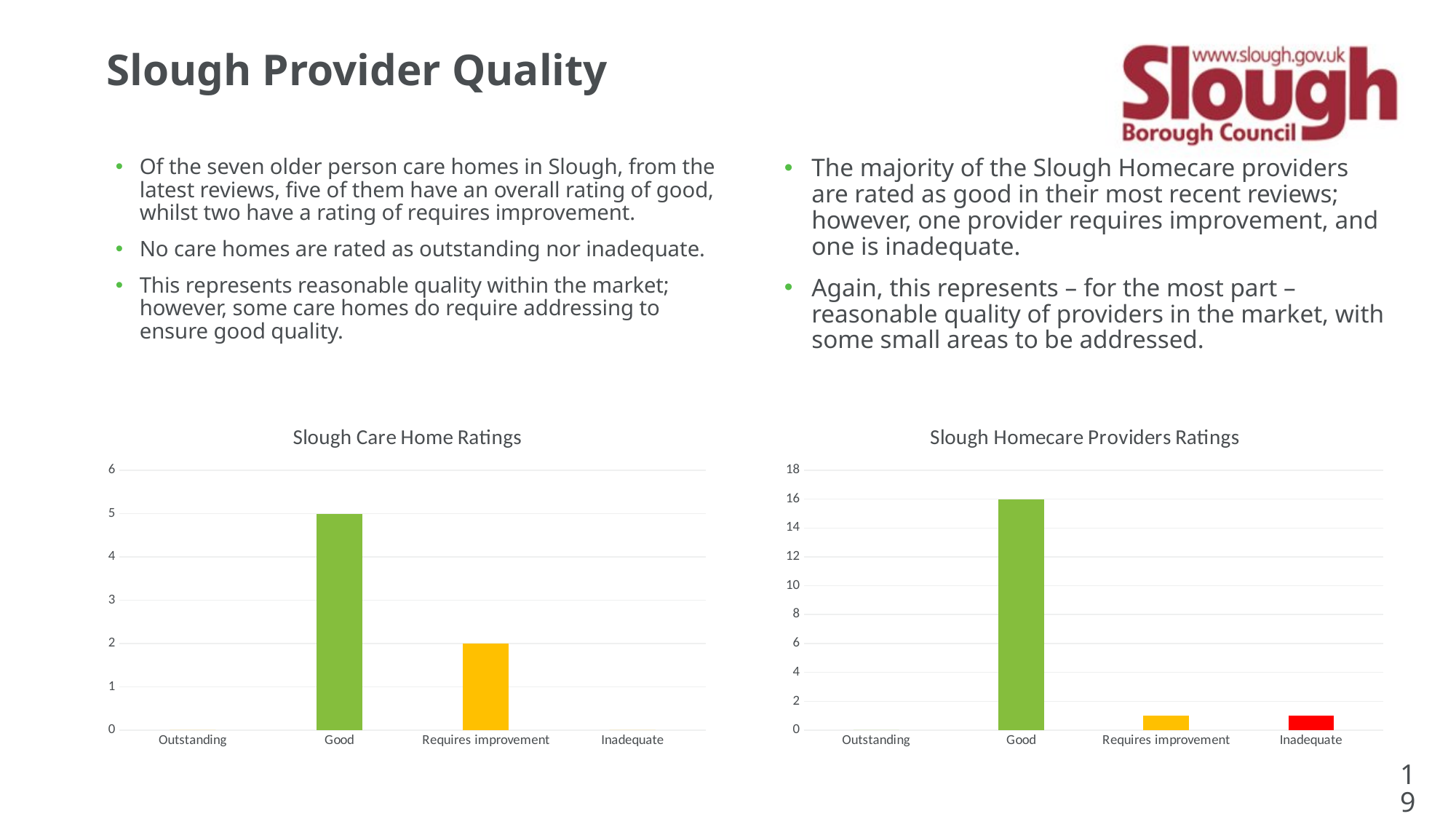
In the Slough Homecare Providers Ratings chart, is the value for Requires improvement greater or less than 2? less In the Slough Care Home Ratings chart, what kind of chart is shown? Bar chart In the Slough Homecare Providers Ratings chart, is the value for Good greater or less than 10? greater In the Slough Care Home Ratings chart, what is the value for Good? 5 In the Slough Homecare Providers Ratings chart, what colour is the Inadequate bar? Red In the Slough Care Home Ratings chart, what is the difference between the values for Good and Requires improvement? 3 In the Slough Care Home Ratings chart, how many categories are shown on the x axis? 4 In the Slough Homecare Providers Ratings chart, what is the value for Good? 16 In the Slough Care Home Ratings chart, which category has the highest value? Good In the Slough Homecare Providers Ratings chart, which category has the highest value? Good In the Slough Care Home Ratings chart, what is the value for Requires improvement? 2 In the Slough Homecare Providers Ratings chart, which is larger, the value for Good or the value for Inadequate? Good